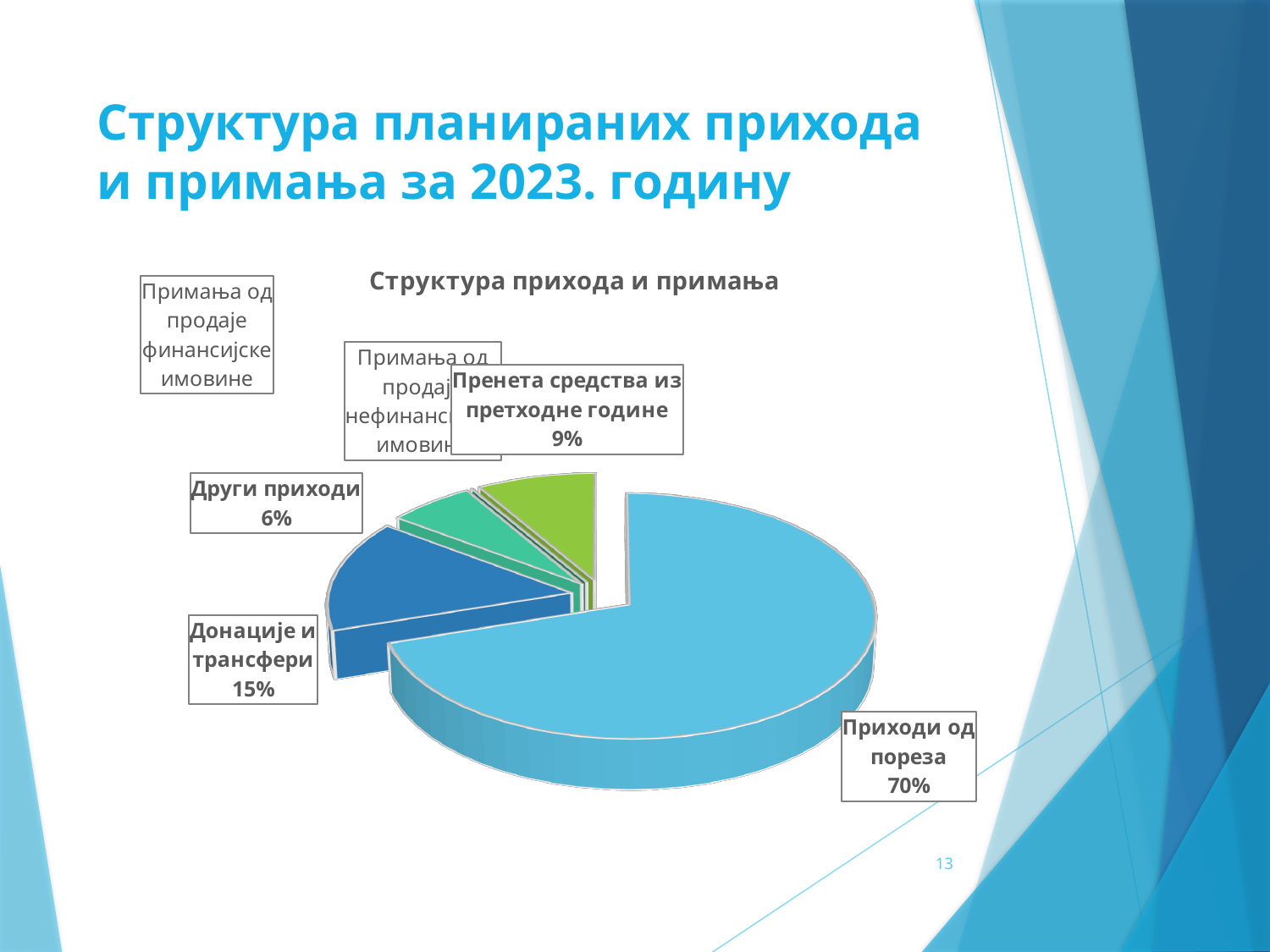
What percentage is shown for "Донације и трансфери"? 15% What is the difference in percentage points between "Приходи од пореза" and "Донације и трансфери"? 55 percentage points What is the title of the chart? Структура прихода и примања What share of the pie does "Приходи од пореза" represent? 70% Which category has the largest slice of the pie? Приходи од пореза Which is larger, "Други приходи" or "Пренета средства из претходне године"? Пренета средства из претходне године What type of chart is shown on the slide? Pie chart How many categories are labelled on the pie chart? 6 What is the difference in percentage points between "Пренета средства из претходне године" and "Други приходи"? 3 percentage points What share is labelled for "Пренета средства из претходне године"? 9% Which is larger, "Донације и трансфери" or "Пренета средства из претходне године"? Донације и трансфери What percentage is shown for "Други приходи"? 6%